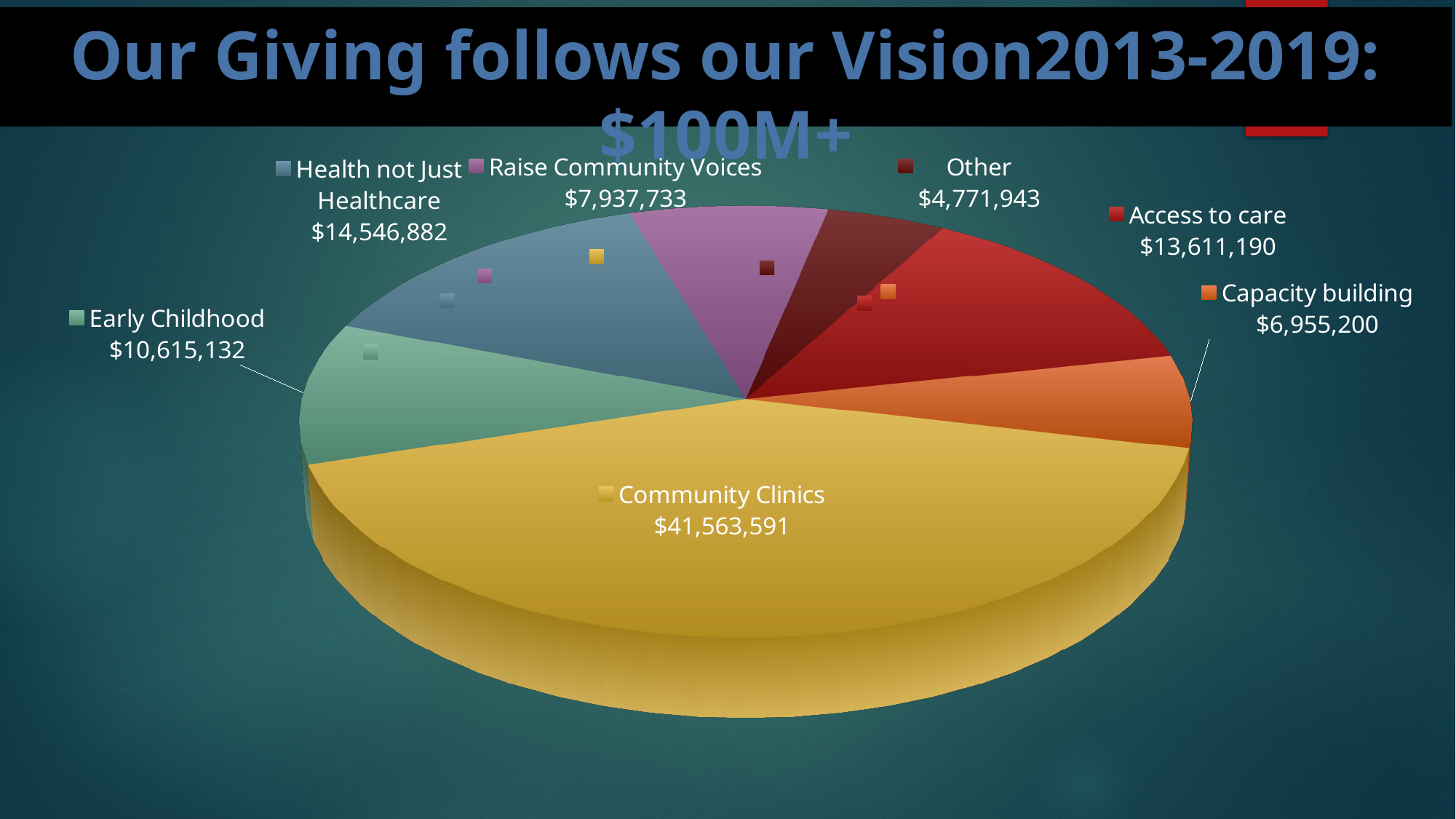
What is the value for Community Clinics? $41,563,591 Which is larger, Health not Just Healthcare or Access to care? Health not Just Healthcare What is the difference between Community Clinics and Health not Just Healthcare? $27,016,709 What is the value for Capacity building? $6,955,200 What kind of chart is shown on the slide? pie chart Which category has the largest slice of the pie? Community Clinics What is the difference between Access to care and Capacity building? $6,655,990 What is the value for Health not Just Healthcare? $14,546,882 What is the value for Other? $4,771,943 What is the title of the slide? Our Giving follows our Vision2013-2019: $100M+ Which category has the smallest slice of the pie? Other How many categories are shown in the pie chart? 7